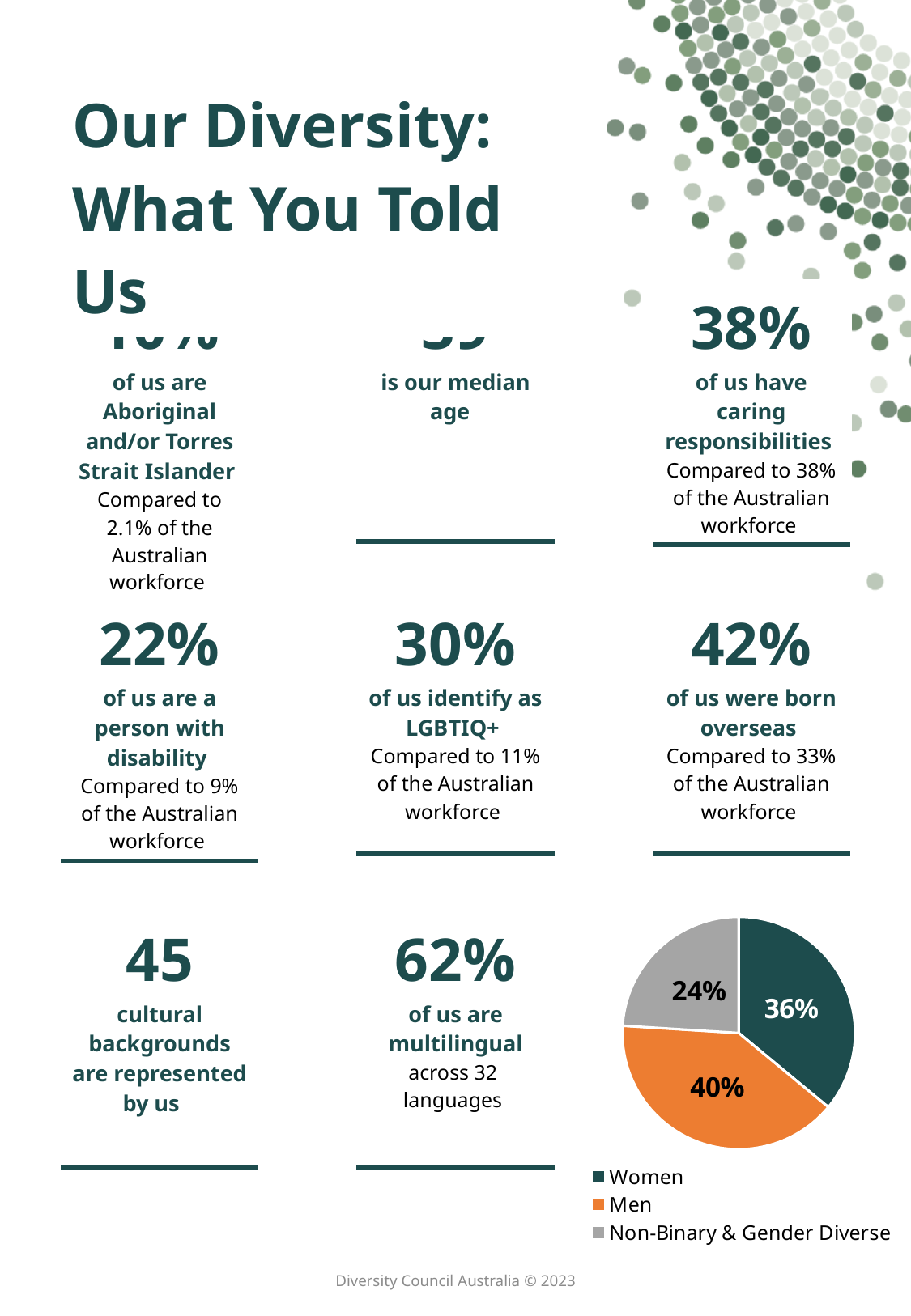
Which slice of the pie chart is larger, Women or Men? Men How many slices does the pie chart have? 3 Which category has the smallest slice of the pie chart? Non-Binary & Gender Diverse What share of the pie chart is Women? 36% Which category has the largest slice of the pie chart? Men What kind of chart is shown on the slide? Pie chart What share of the pie chart is Non-Binary & Gender Diverse? 24% What is the difference in percentage points between the Men and Women slices of the pie chart? 4 How many entries does the pie chart legend list? 3 What share of the pie chart is Men? 40% What is the difference in percentage points between the Women and Non-Binary & Gender Diverse slices of the pie chart? 12 What colour is the Men slice in the pie chart? Orange